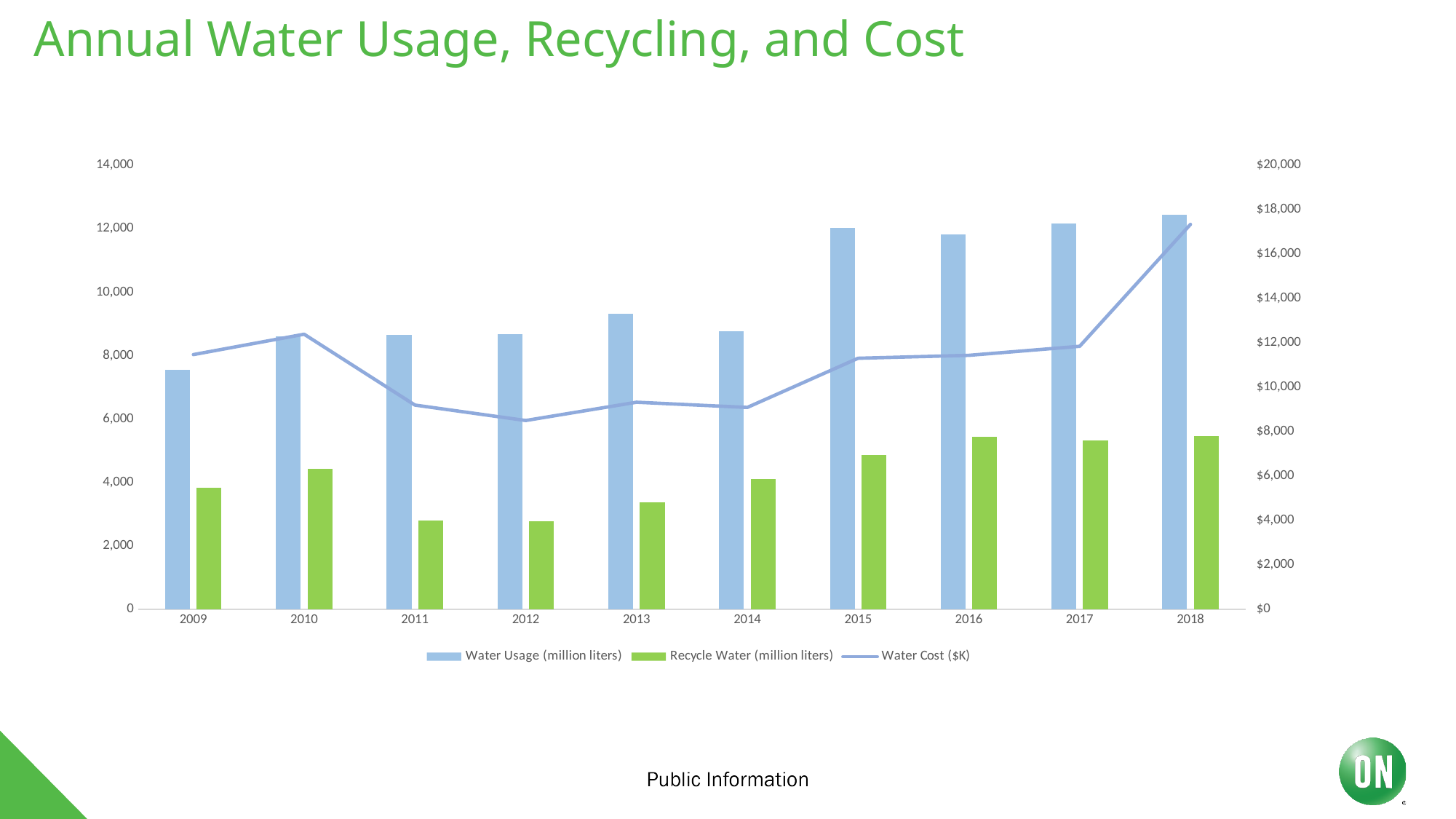
How many years are shown on the x axis? 10 What kind of chart is shown on the slide? A combined bar and line chart Does the Water Cost ($K) line rise or fall from 2014 to 2018? rise Which year has the larger Recycle Water (million liters), 2010 or 2011? 2010 How many series does the legend list? 3 Is the Recycle Water (million liters) value for 2016 greater or less than 4,000? greater Which year has the larger Water Usage (million liters), 2014 or 2015? 2015 Is the Water Usage (million liters) value for 2015 greater or less than 10,000? greater Which year has the highest Water Cost ($K)? 2018 Which year has the lowest Water Usage (million liters)? 2009 Is the Water Cost ($K) value for 2018 greater or less than $16,000? greater Which year has the lowest Water Cost ($K)? 2012